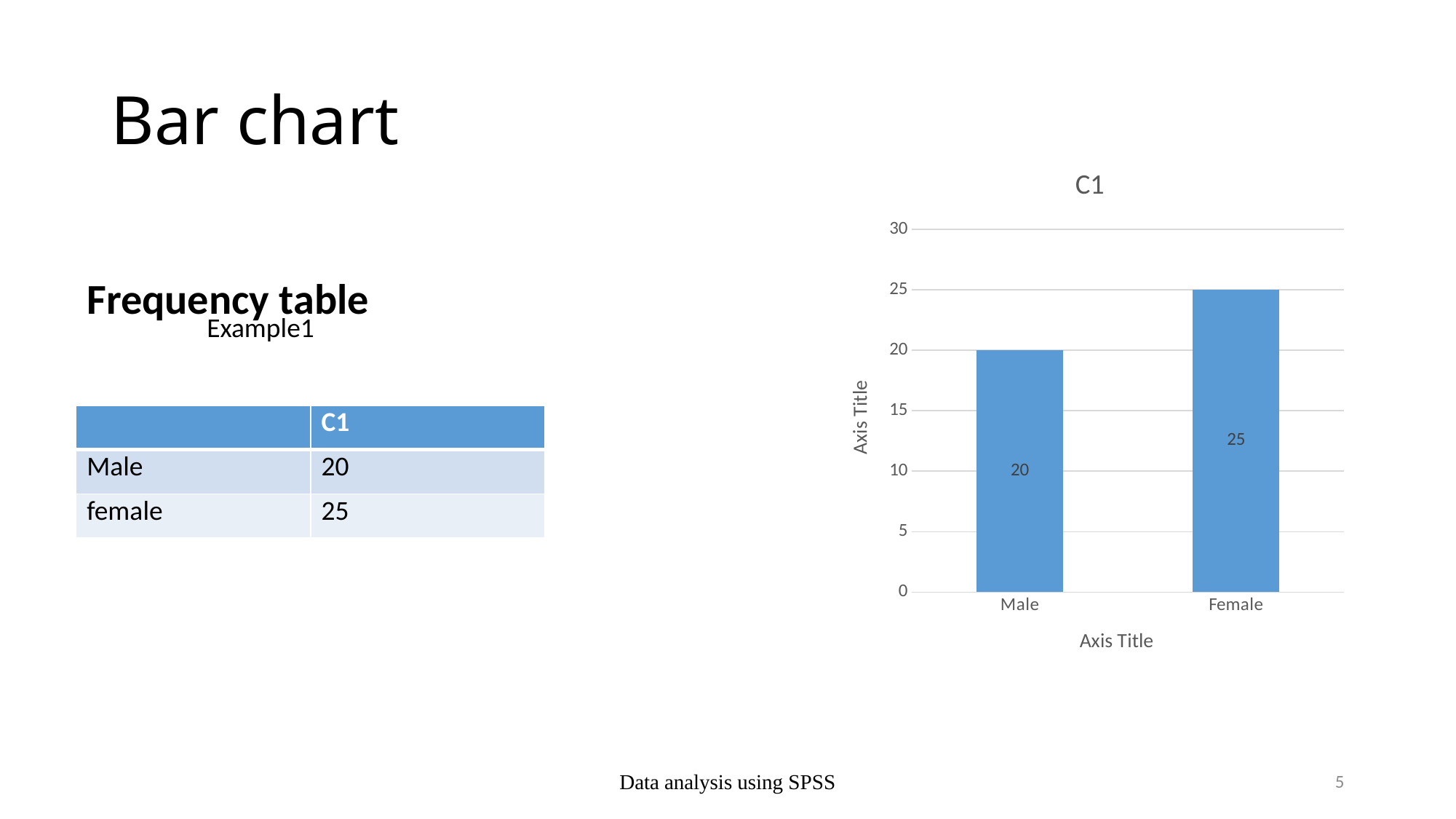
Which category has the highest value in the chart? Female What is the title of the chart? C1 How many categories are shown on the x axis of the chart? 2 What is the value for Male in the chart? 20 What kind of chart is shown on the slide? bar chart What is the highest value shown on the chart's vertical axis? 30 Is the value for Female greater or less than 20? greater What is the value for Female in the chart? 25 Which is larger, the value for Male or the value for Female? Female What is the difference between the values for Female and Male? 5 Is the value for Male greater or less than 25? less Which category has the lowest value in the chart? Male